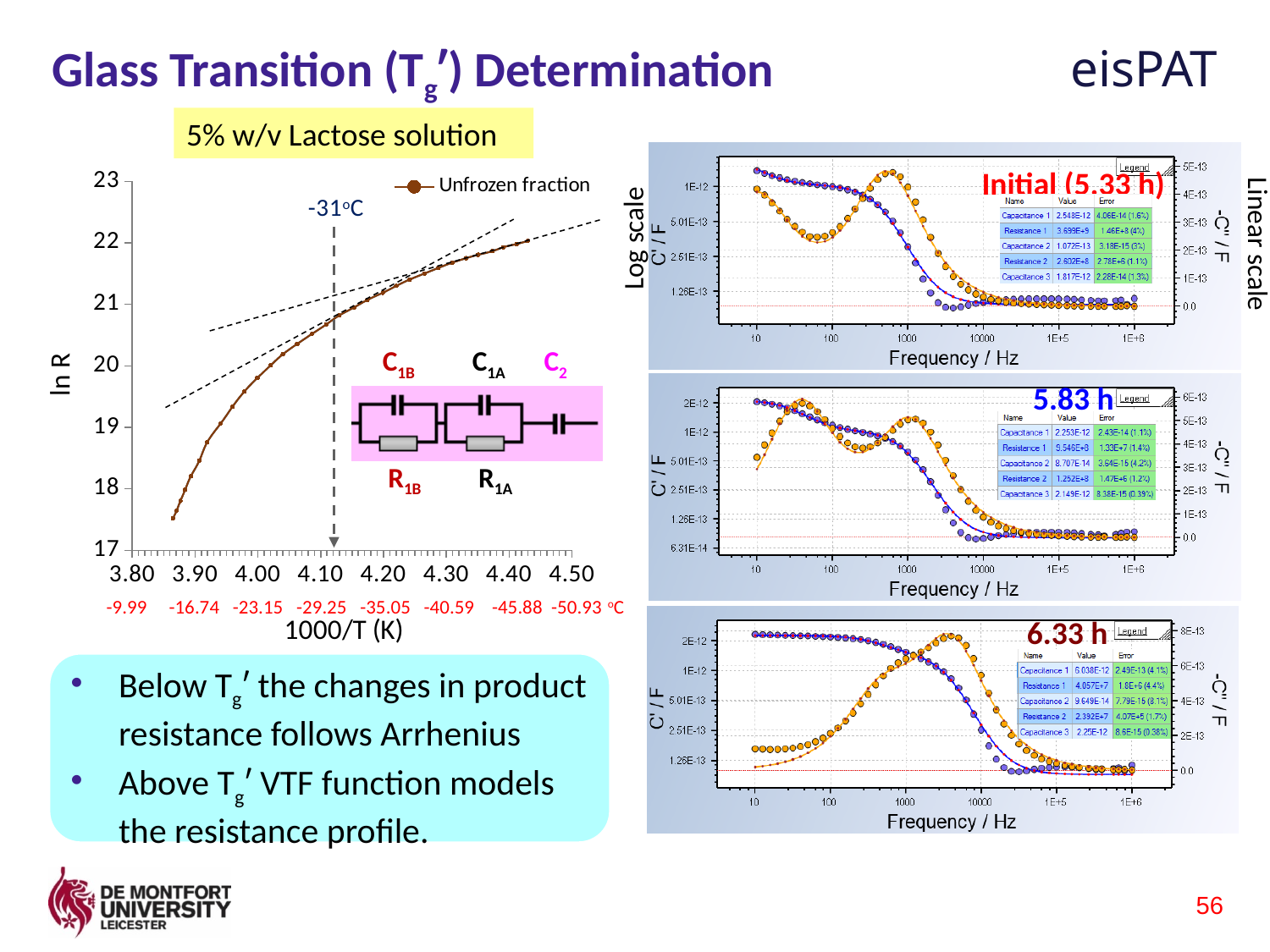
In the 'ln R' chart, is the value of ln R at 1000/T = 3.90 greater or less than 19? less How many temperature values in °C are printed in red below the x axis of the 'ln R' chart? 8 What is the label of the y axis of the chart on the left of the slide? ln R What temperature is marked by the dashed vertical arrow in the 'ln R' chart? -31°C How many frequency-spectrum charts are shown on the right side of the slide? 3 How many series does the legend of the 'ln R' chart list? 1 What is the x-axis label of the three charts on the right side of the slide? Frequency / Hz In the 'ln R' chart, is the value of ln R at 1000/T = 4.40 greater or less than 21? greater In the 'ln R' chart, does ln R rise or fall as 1000/T increases along the x axis? rise What kind of chart is the 'ln R' versus '1000/T (K)' chart on the left of the slide? line chart